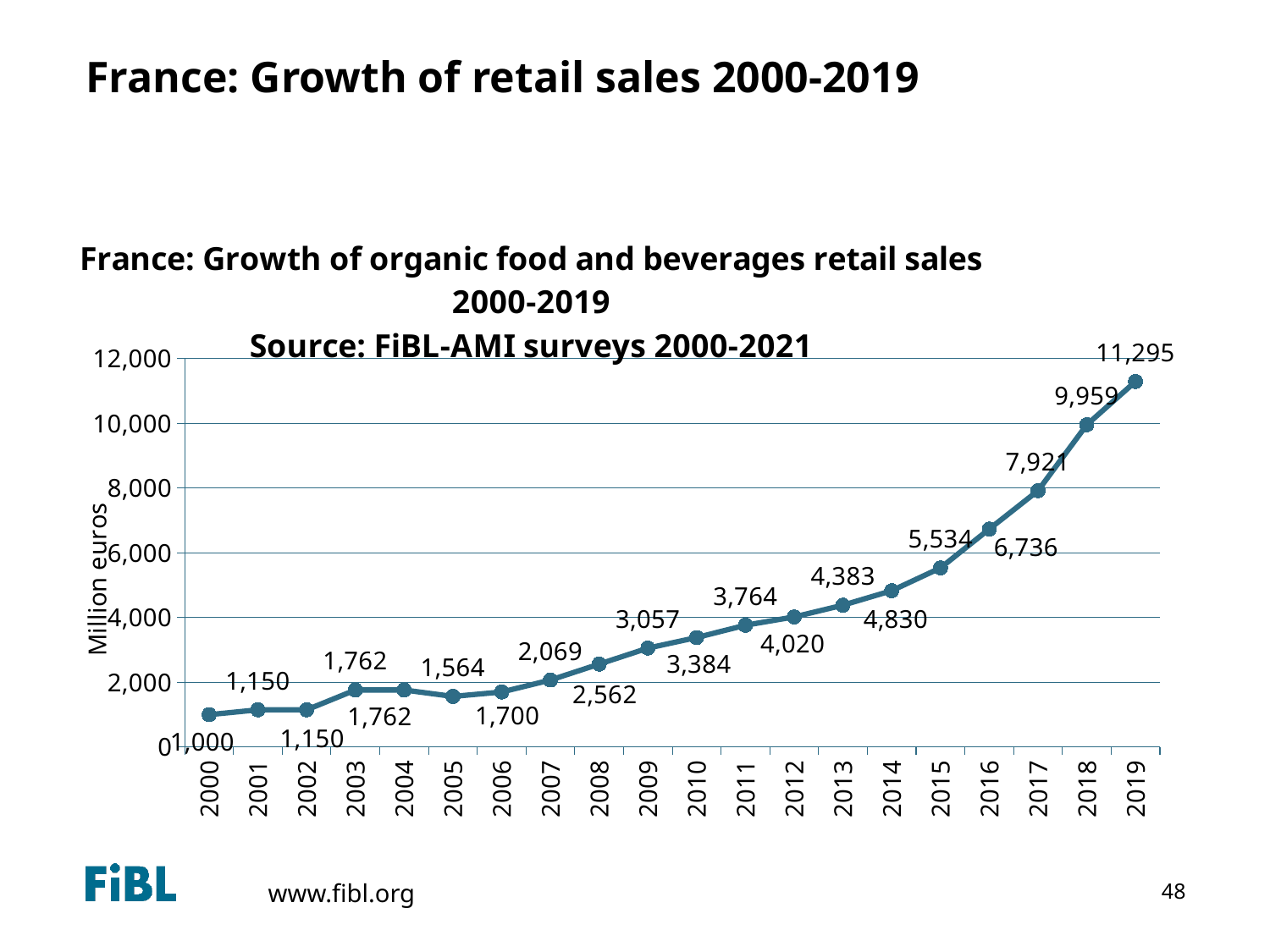
What is the difference between the values for 2019 and 2018? 1,336 What was the value for 2019? 11,295 How many data points are plotted on the chart? 20 What was the value for 2010? 3,384 What was the value for 2005? 1,564 Is the value for 2016 greater or less than 6,000? greater Which is larger, the value for 2005 or the value for 2006? 2006 Which year has the highest value? 2019 What kind of chart is shown? Line chart What is the label on the vertical axis? Million euros Which year has the lowest value? 2000 What was the value for 2015? 5,534